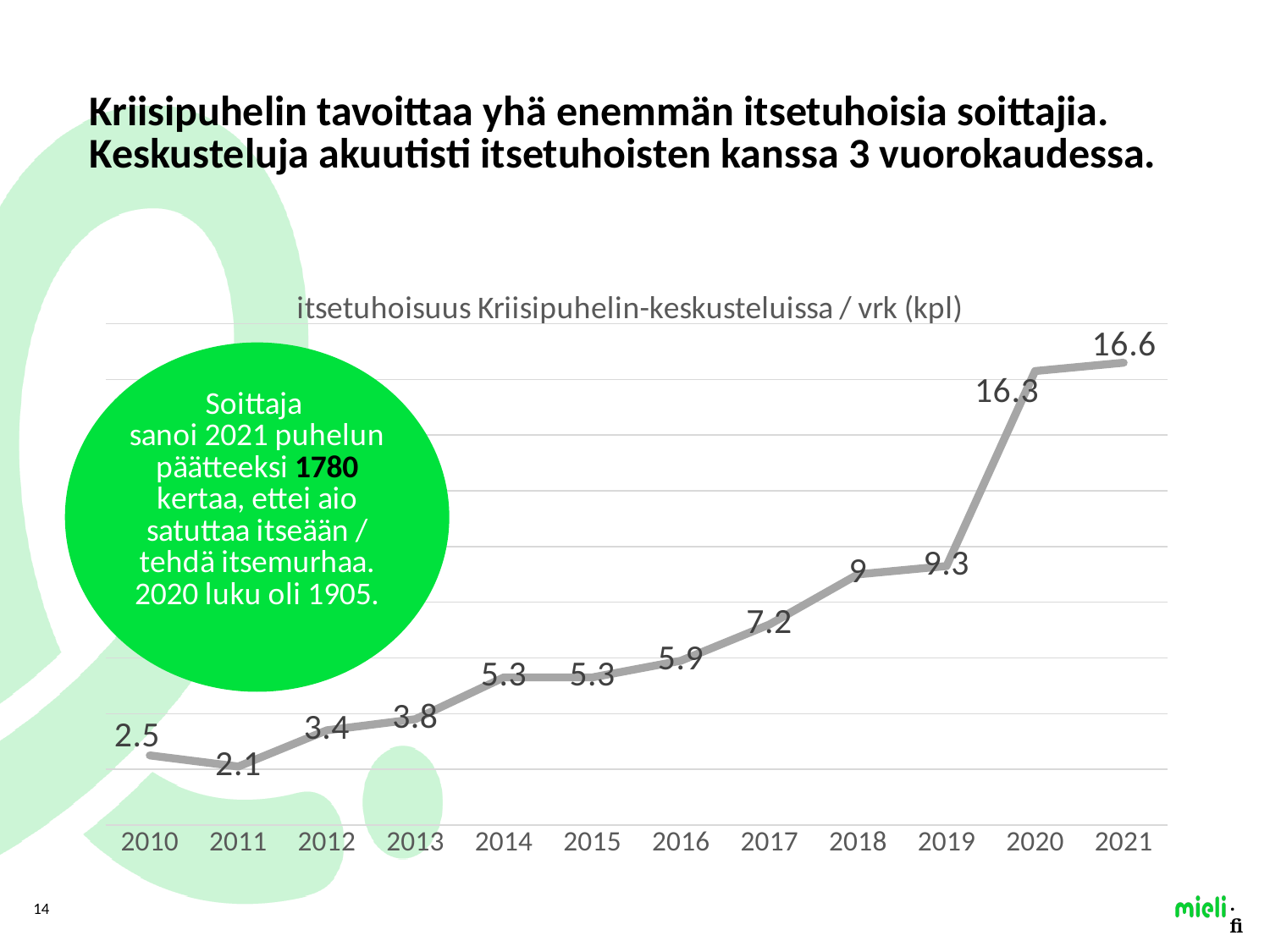
Which year has the lowest value? 2011 Which is larger, the value for 2018 or the value for 2016? 2018 What is the value for 2017? 7.2 What kind of chart is shown on the slide? line chart What is the difference between the values for 2021 and 2010? 14.1 Which year has the highest value? 2021 What is the title of the chart? itsetuhoisuus Kriisipuhelin-keskusteluissa / vrk (kpl) What is the difference between the values for 2020 and 2019? 7 How many years are plotted on the chart? 12 What is the value for 2021? 16.6 What is the value for 2010? 2.5 What is the value for 2020? 16.3